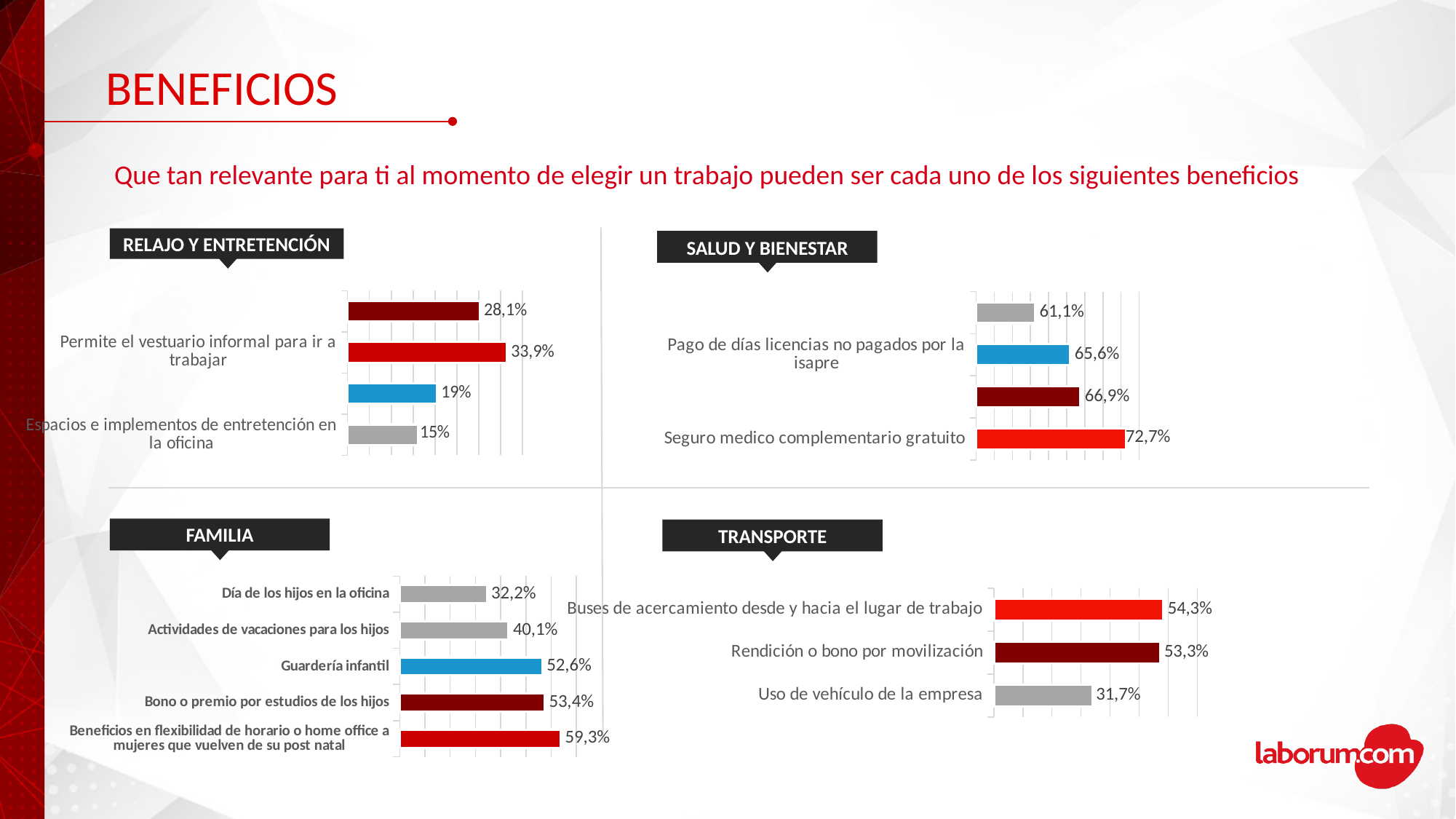
In the FAMILIA chart, what is the value for Guardería infantil? 52,6% In the FAMILIA chart, what is the difference between Actividades de vacaciones para los hijos and Día de los hijos en la oficina? 7,9 percentage points In the TRANSPORTE chart, which category has the highest value? Buses de acercamiento desde y hacia el lugar de trabajo In the FAMILIA chart, which category has the lowest value? Día de los hijos en la oficina In the TRANSPORTE chart, what is the value for Uso de vehículo de la empresa? 31,7% How many categories are shown in the FAMILIA chart? 5 In the TRANSPORTE chart, which is larger: Buses de acercamiento desde y hacia el lugar de trabajo or Rendición o bono por movilización? Buses de acercamiento desde y hacia el lugar de trabajo In the SALUD Y BIENESTAR chart, what is the value for Seguro medico complementario gratuito? 72,7% What type of chart is the FAMILIA chart? Bar chart How many categories are shown in the TRANSPORTE chart? 3 In the FAMILIA chart, which category has the highest value? Beneficios en flexibilidad de horario o home office a mujeres que vuelven de su post natal In the RELAJO Y ENTRETENCIÓN chart, what is the value for Espacios e implementos de entretención en la oficina? 15%